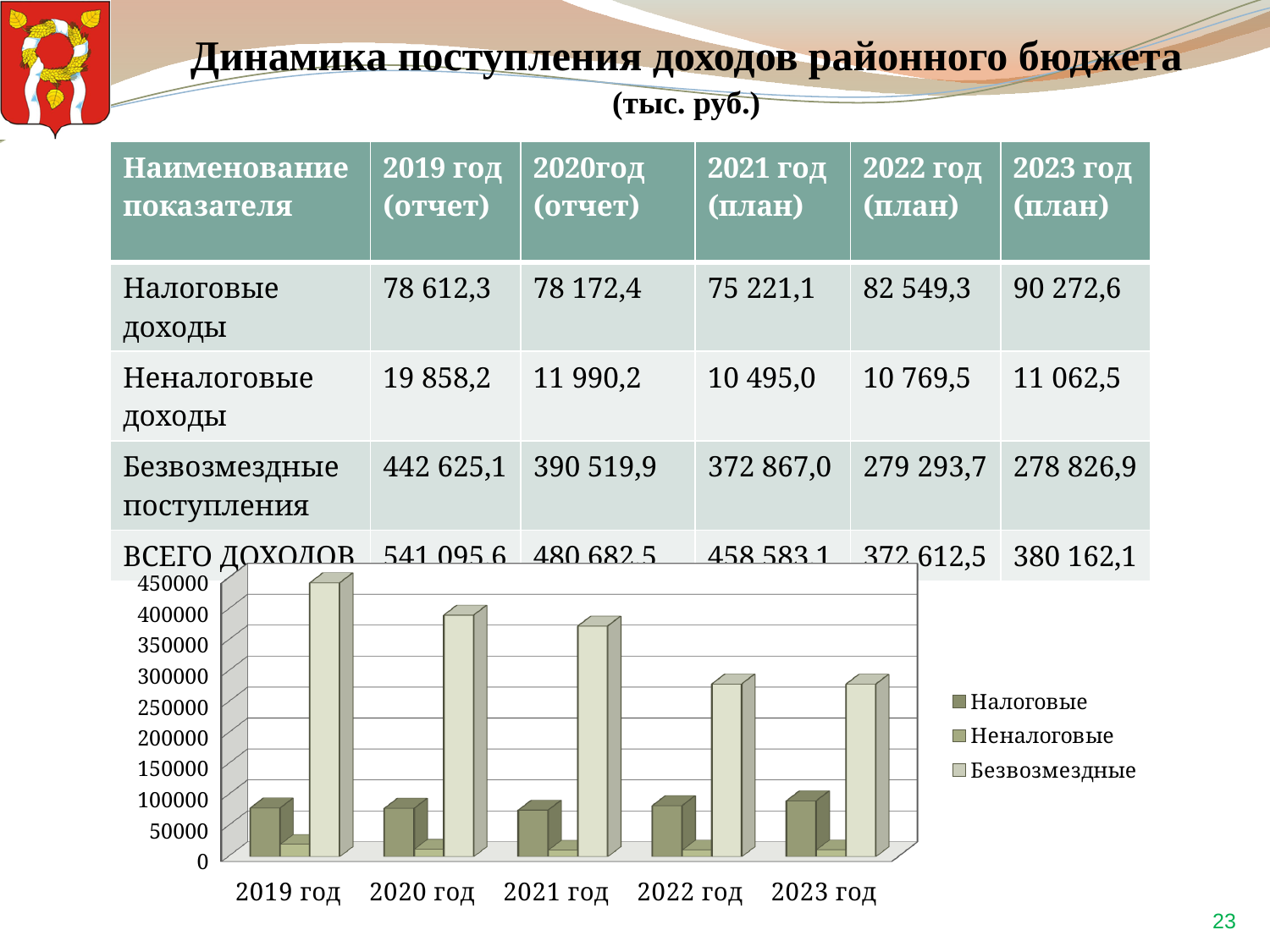
In 2019 год, which bar is taller: Налоговые or Неналоговые? Налоговые How many year categories are shown on the x axis of the chart? 5 Do the Безвозмездные bars rise or fall from 2019 год to 2023 год? fall How many series does the chart legend list? 3 Is the Неналоговые bar for 2019 год greater or less than 50000? less Is the Безвозмездные bar for 2019 год greater or less than 400000? greater Which year has the highest bar for Безвозмездные in the chart? 2019 год Which series is listed last in the chart legend? Безвозмездные What kind of chart is shown at the bottom of the slide? bar chart Is the Безвозмездные bar for 2022 год greater or less than 300000? less